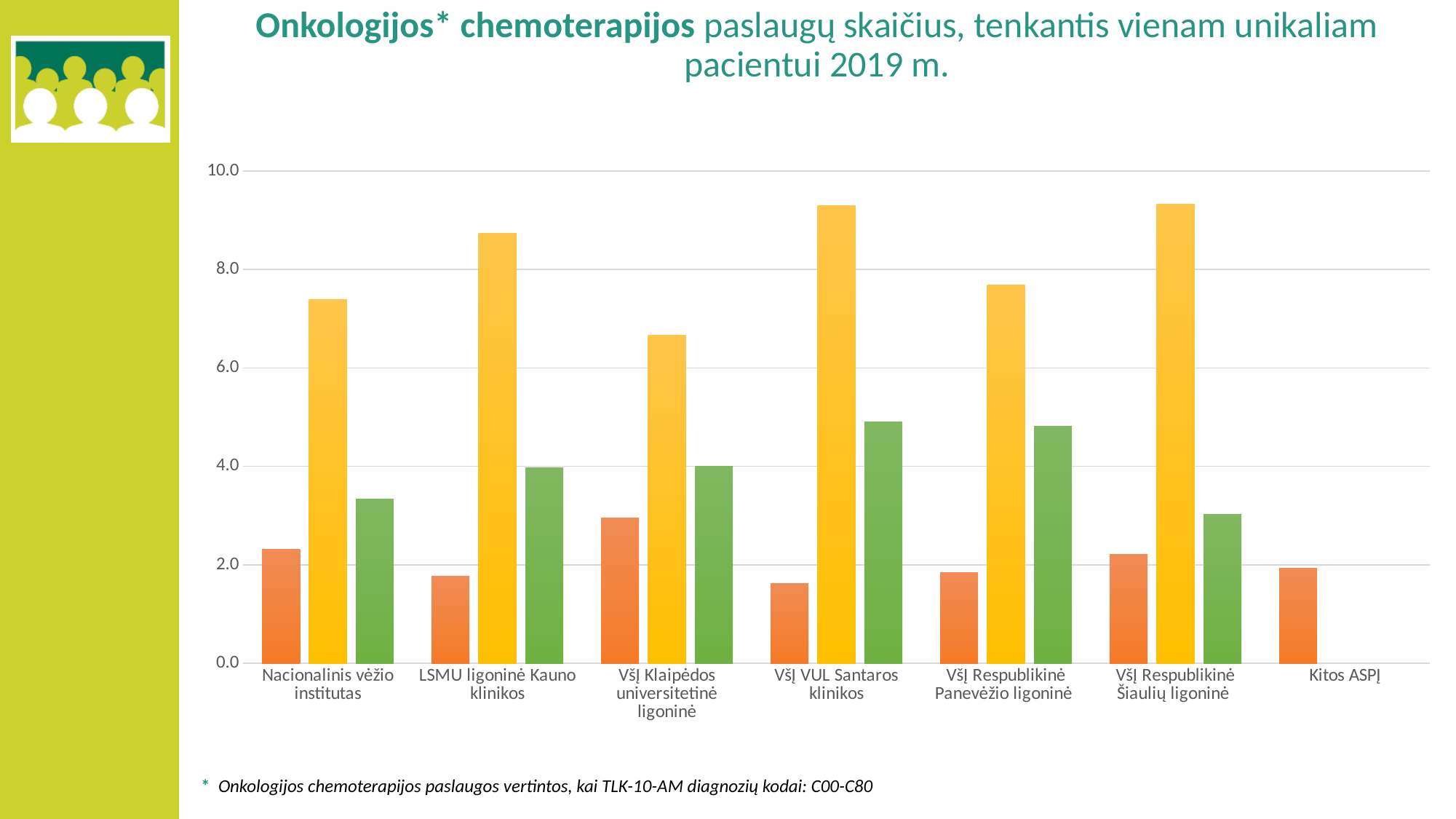
Is the yellow bar for LSMU ligoninė Kauno klinikos greater or less than 8.0? greater How many bars are shown for the Kitos ASPĮ category? 1 Which is larger: the yellow bar for LSMU ligoninė Kauno klinikos or the yellow bar for Nacionalinis vėžio institutas? LSMU ligoninė Kauno klinikos What kind of chart is shown on the slide? bar chart Is the yellow bar for VšĮ Klaipėdos universitetinė ligoninė greater or less than 8.0? less How many categories (institutions) are shown along the x axis? 7 Which category has the highest orange bar? VšĮ Klaipėdos universitetinė ligoninė Which category has the lowest yellow bar? VšĮ Klaipėdos universitetinė ligoninė Is the green bar for VšĮ VUL Santaros klinikos greater or less than 4.0? greater